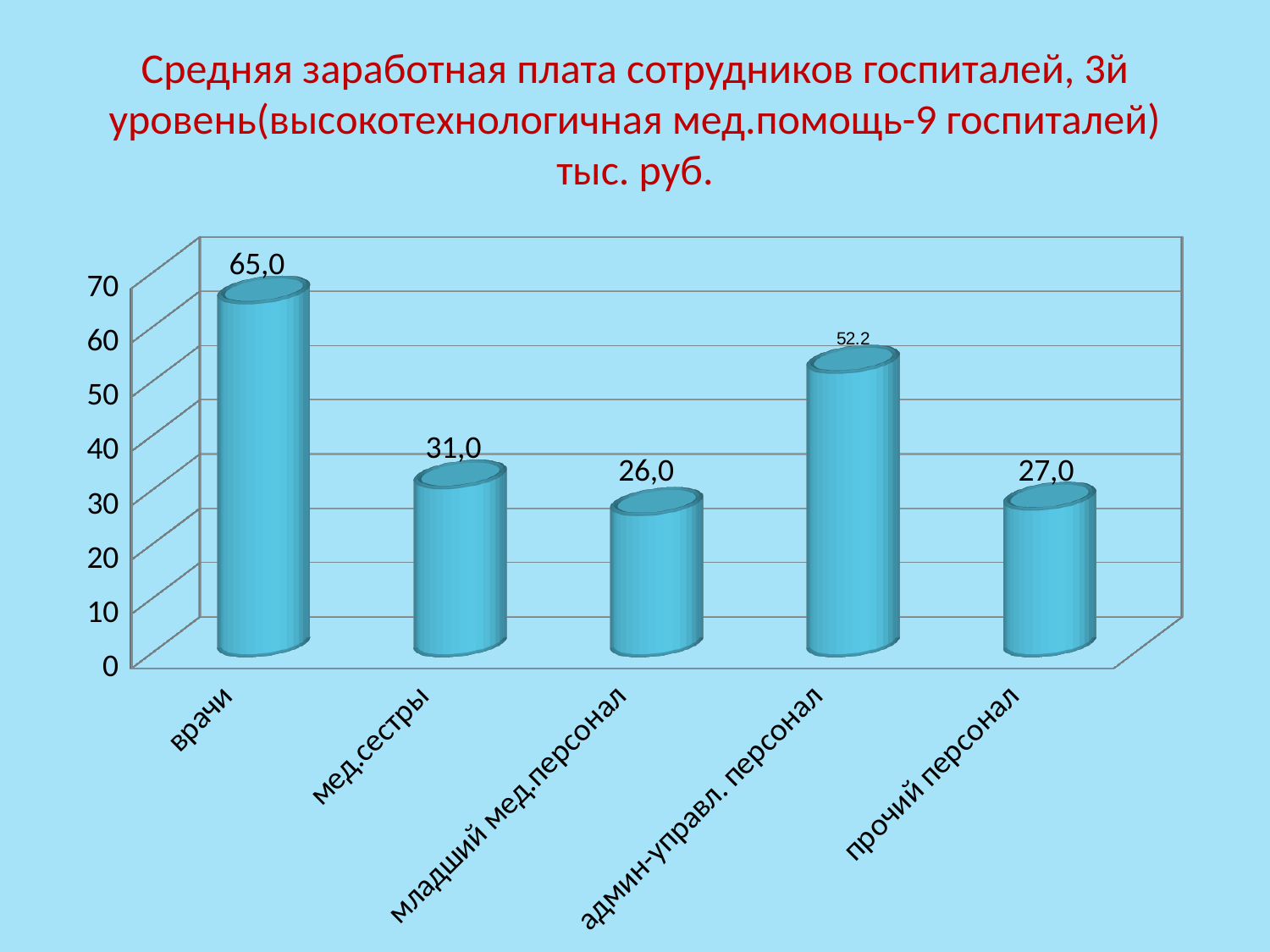
What is the difference between the values for врачи and мед.сестры? 34,0 What is the value for врачи? 65,0 Which category has the lowest value? младший мед.персонал What is the value for админ-управл. персонал? 52.2 What is the value for младший мед.персонал? 26,0 What kind of chart is shown on the slide? bar chart What is the value for прочий персонал? 27,0 What is the value for мед.сестры? 31,0 How many categories are shown on the chart? 5 Which is larger, the value for мед.сестры or the value for прочий персонал? мед.сестры Which category has the highest value? врачи What unit is stated in the chart title? тыс. руб.